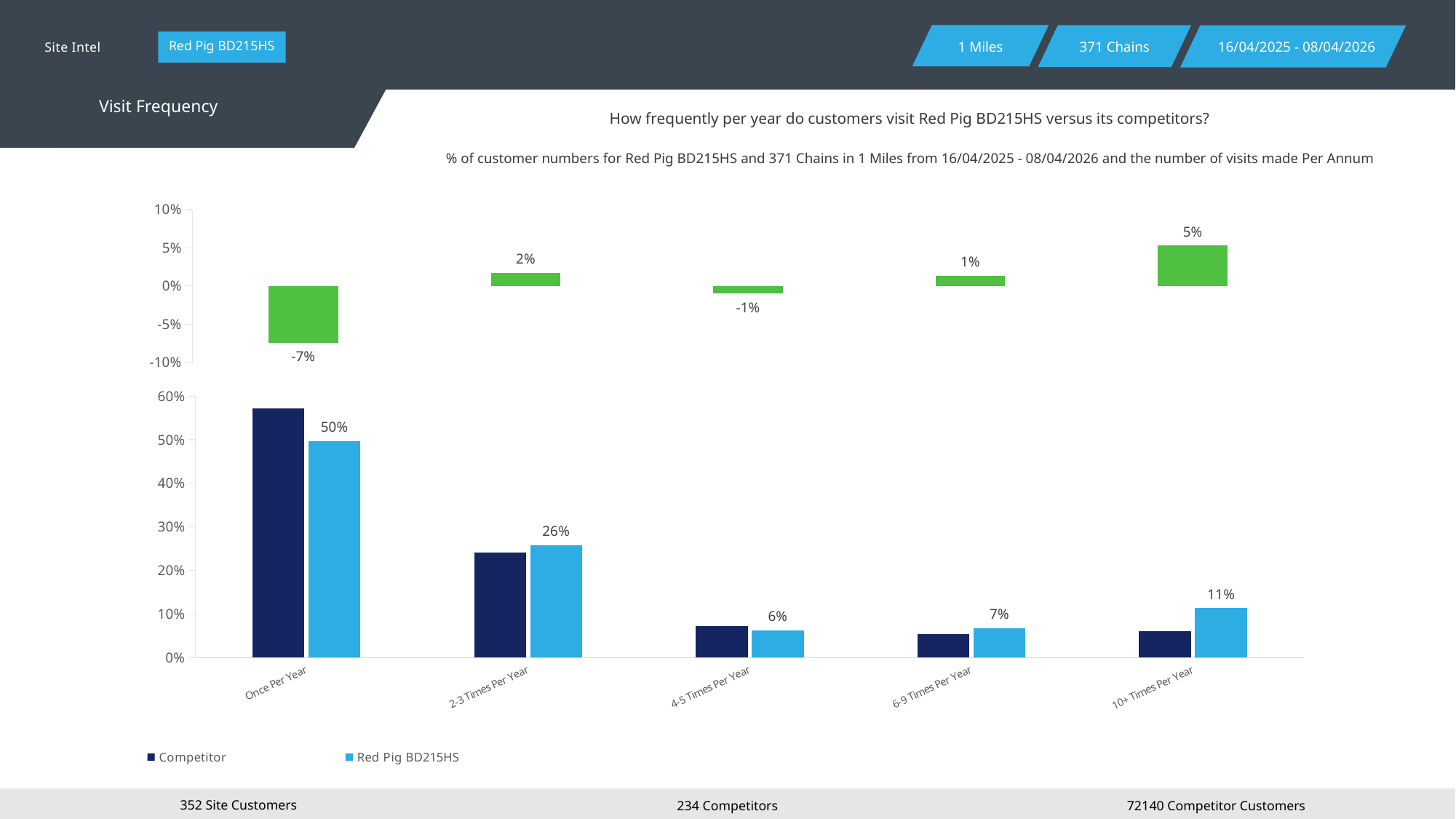
In the top chart, what is the value shown for the Once Per Year category? -7% In the top chart, which category has the lowest value? Once Per Year In the bottom chart, which category has the highest Red Pig BD215HS value? Once Per Year In the bottom chart, which is larger for Once Per Year: the Competitor bar or the Red Pig BD215HS bar? Competitor In the bottom chart, what is the difference between the Red Pig BD215HS values for Once Per Year and 2-3 Times Per Year? 24% How many series does the legend of the bottom chart list? 2 In the top chart, which category has the highest value? 10+ Times Per Year In the bottom chart, what is the value for Red Pig BD215HS in the 2-3 Times Per Year category? 26% In the top chart, what is the value shown for the 10+ Times Per Year category? 5% In the bottom chart, what is the value for Red Pig BD215HS in the 10+ Times Per Year category? 11% In the bottom chart, is the Competitor value for Once Per Year greater or less than 50%? greater In the bottom chart, what is the value for Red Pig BD215HS in the Once Per Year category? 50%